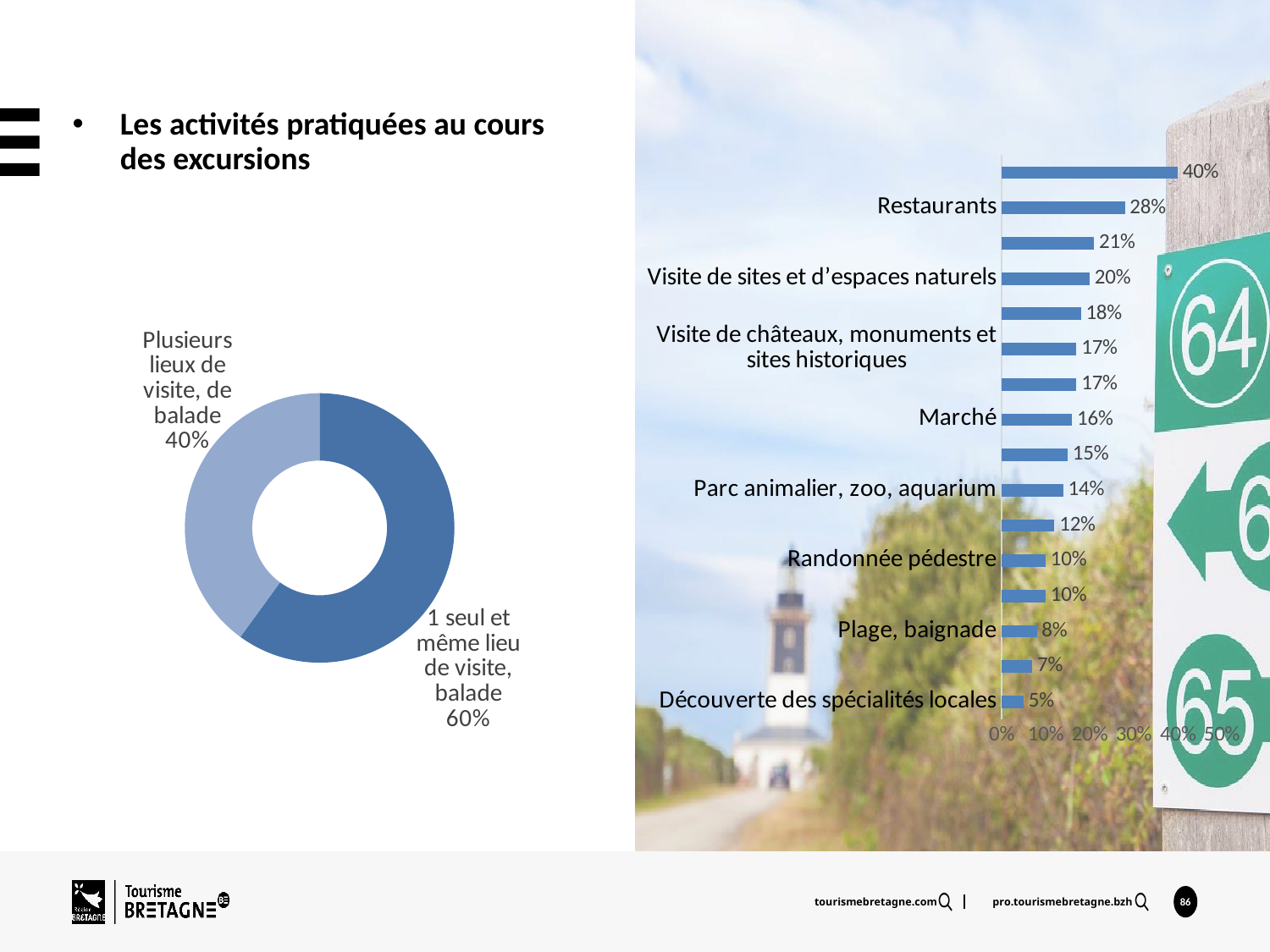
On the donut chart on the left, how many slices are there? 2 On the bar chart on the right, what is the value for Restaurants? 28% On the bar chart on the right, which labelled category has the lowest value? Découverte des spécialités locales On the bar chart on the right, what is the value for Marché? 16% On the bar chart on the right, what is the highest value shown on any bar? 40% On the bar chart on the right, what is the difference between the values for Restaurants and Marché? 12 percentage points On the bar chart on the right, what is the value for Visite de châteaux, monuments et sites historiques? 17% On the donut chart on the left, what share is shown for '1 seul et même lieu de visite, balade'? 60% On the bar chart on the right, what is the value for Randonnée pédestre? 10% On the bar chart on the right, how many bars are plotted? 16 On the bar chart on the right, which is larger: Parc animalier, zoo, aquarium or Plage, baignade? Parc animalier, zoo, aquarium What kind of chart is shown on the left of the slide? Donut (pie) chart